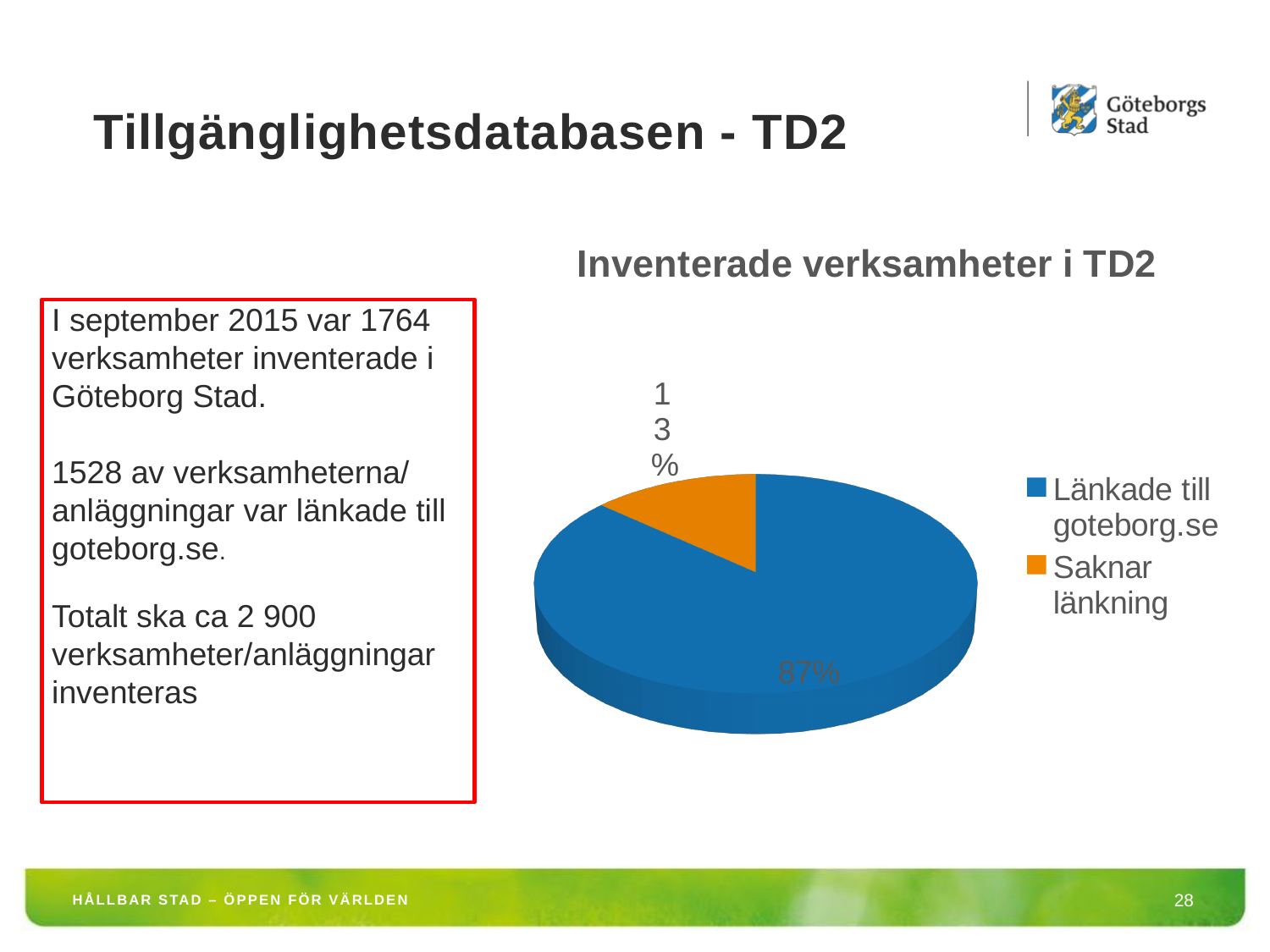
Which slice of the pie is the largest? Länkade till goteborg.se Which is larger, the share for "Länkade till goteborg.se" or the share for "Saknar länkning"? Länkade till goteborg.se What is the title of the chart? Inventerade verksamheter i TD2 How many slices does the pie chart have? 2 What share of the pie is labelled "Saknar länkning"? 13% What kind of chart is shown on the slide? pie chart What colour is the "Saknar länkning" slice? orange How many entries does the legend list? 2 Which slice of the pie is the smallest? Saknar länkning What share of the pie is labelled "Länkade till goteborg.se"? 87% What is the difference in percentage points between the "Länkade till goteborg.se" slice and the "Saknar länkning" slice? 74